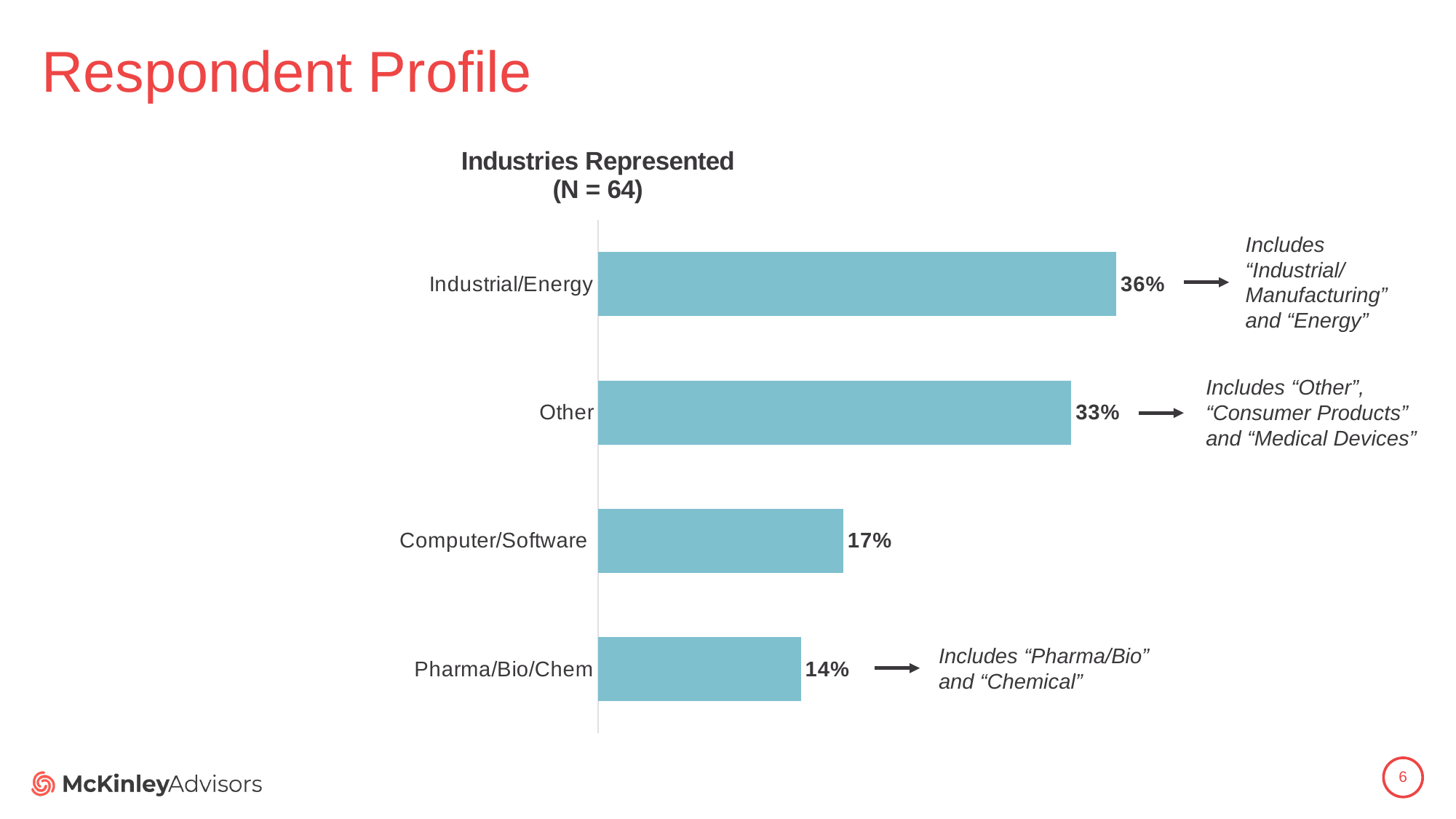
What is the value shown for Computer/Software? 17% What type of chart is used to show the industries represented? Bar chart What is the difference in percentage points between Computer/Software and Pharma/Bio/Chem? 3 percentage points According to the annotation, which groups does the Other category include? "Other", "Consumer Products" and "Medical Devices" Which industry category has the highest share of respondents? Industrial/Energy Which industry category has the lowest share of respondents? Pharma/Bio/Chem What is the difference in percentage points between Industrial/Energy and Other? 3 percentage points How many industry categories are shown in the chart? 4 What percentage of respondents are in the Industrial/Energy industry? 36% What is the value shown for Pharma/Bio/Chem? 14% What is the title of the chart? Industries Represented (N = 64) Which is larger, the value for Other or the value for Computer/Software? Other